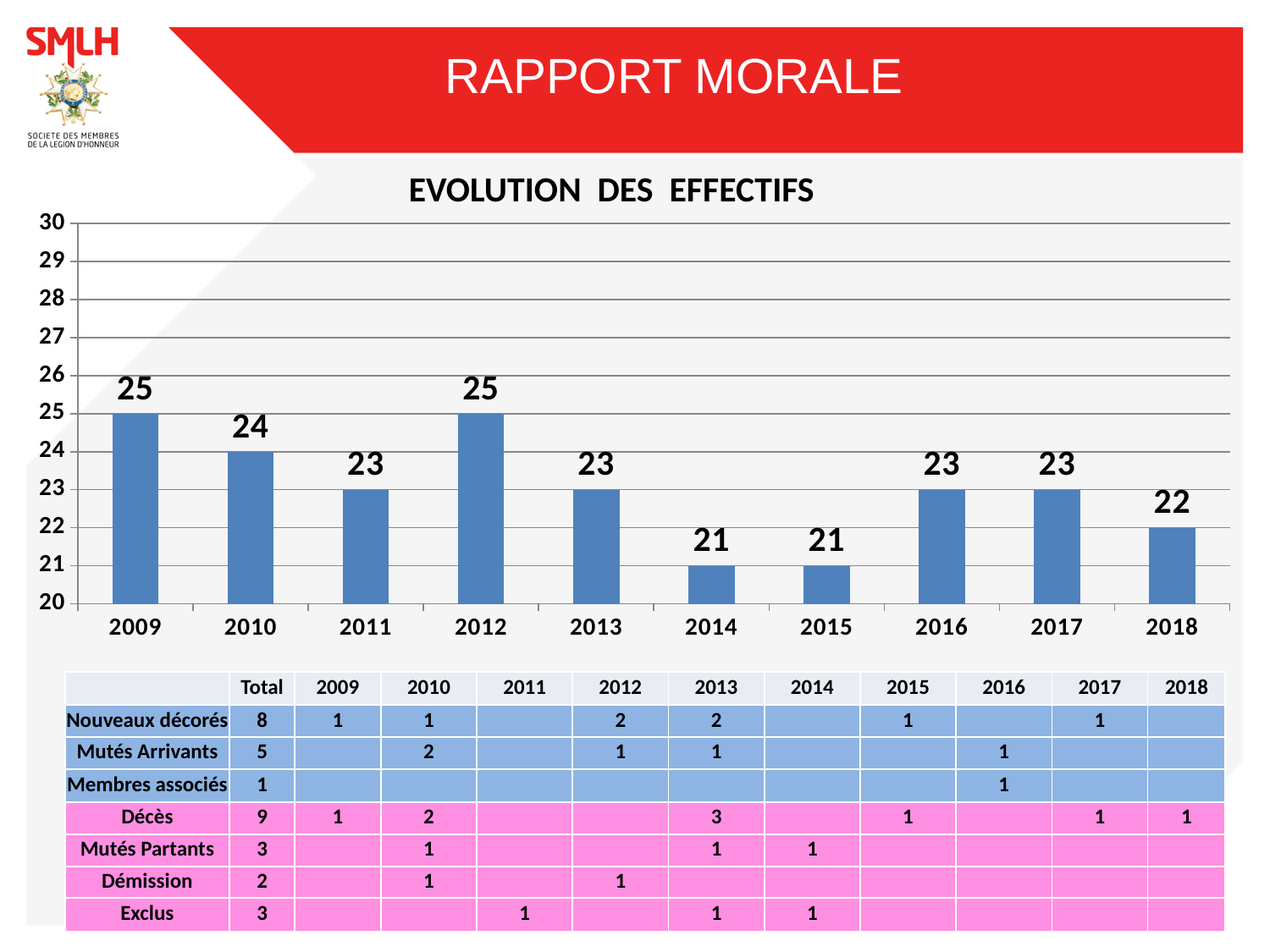
Which year has the larger value in the EVOLUTION DES EFFECTIFS chart, 2010 or 2018? 2010 What is the lowest value shown in the EVOLUTION DES EFFECTIFS chart? 21 What is the value for 2018 in the EVOLUTION DES EFFECTIFS chart? 22 What is the value for 2009 in the EVOLUTION DES EFFECTIFS chart? 25 How many years are shown on the x axis of the EVOLUTION DES EFFECTIFS chart? 10 Do the values in the EVOLUTION DES EFFECTIFS chart rise or fall from 2012 to 2014? fall What is the difference between the values for 2012 and 2014 in the EVOLUTION DES EFFECTIFS chart? 4 What is the value for 2014 in the EVOLUTION DES EFFECTIFS chart? 21 What kind of chart is EVOLUTION DES EFFECTIFS? bar chart What is the title of the chart on the slide? EVOLUTION DES EFFECTIFS What is the highest value shown in the EVOLUTION DES EFFECTIFS chart? 25 What is the value for 2010 in the EVOLUTION DES EFFECTIFS chart? 24